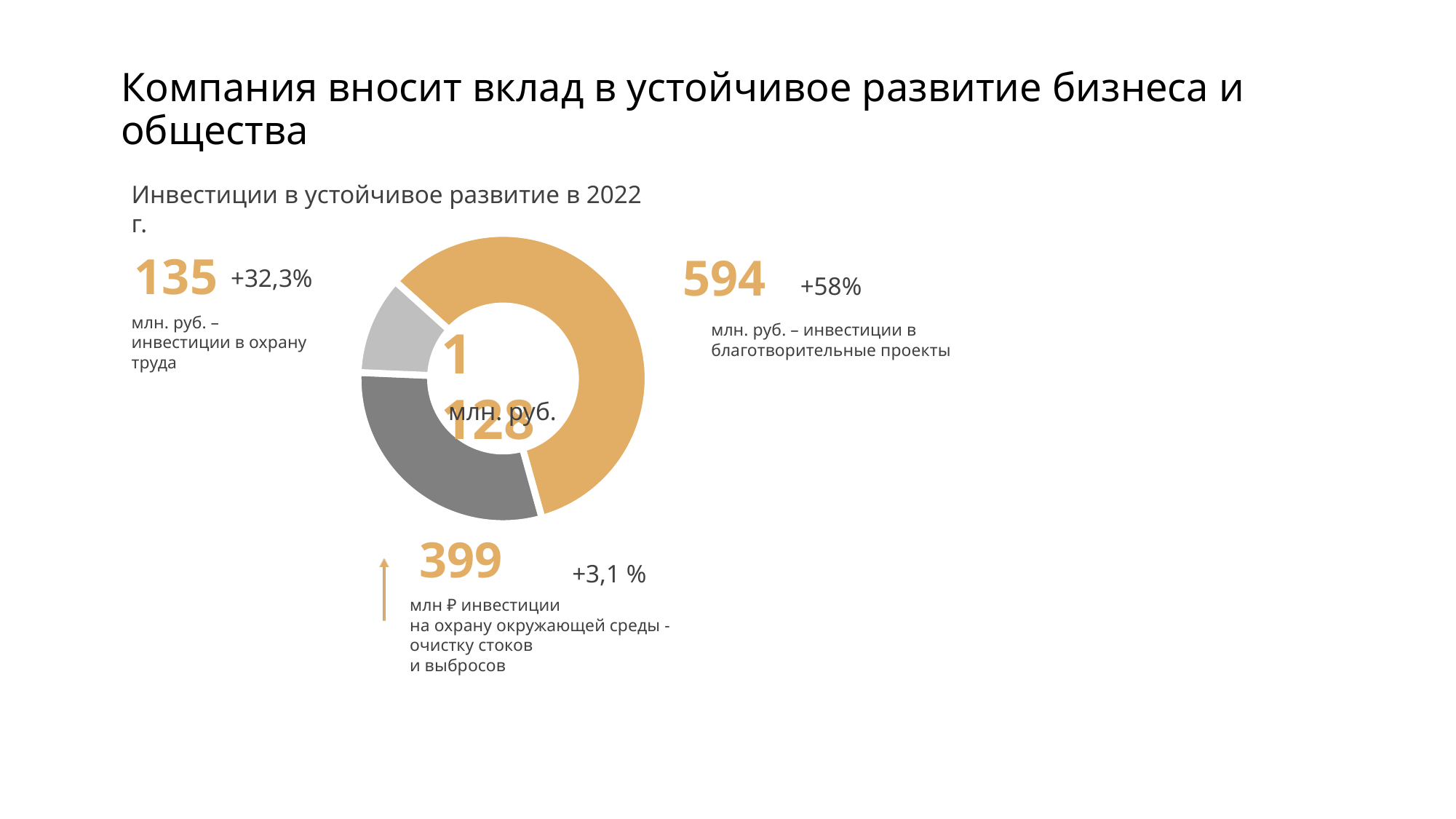
What is the difference between investments in charitable projects and investments in environmental protection? 195 What is the value of investments in environmental protection (инвестиции на охрану окружающей среды), in млн ₽? 399 How many slices does the donut chart have? 3 Which category has the smallest investment value? Инвестиции в охрану труда (135) What is the value of investments in labour protection (инвестиции в охрану труда), in млн. руб.? 135 What is the total of all investments shown in the centre of the donut chart? 1 128 млн. руб. What type of chart is shown on the slide? Donut (pie) chart Which is larger: investments in environmental protection or investments in labour protection? Investments in environmental protection (399) What colour is the slice representing investments in charitable projects? Orange What is the value of investments in charitable projects (инвестиции в благотворительные проекты), in млн. руб.? 594 What year-on-year change is shown for investments in charitable projects? +58% Which category has the largest investment value? Инвестиции в благотворительные проекты (594)